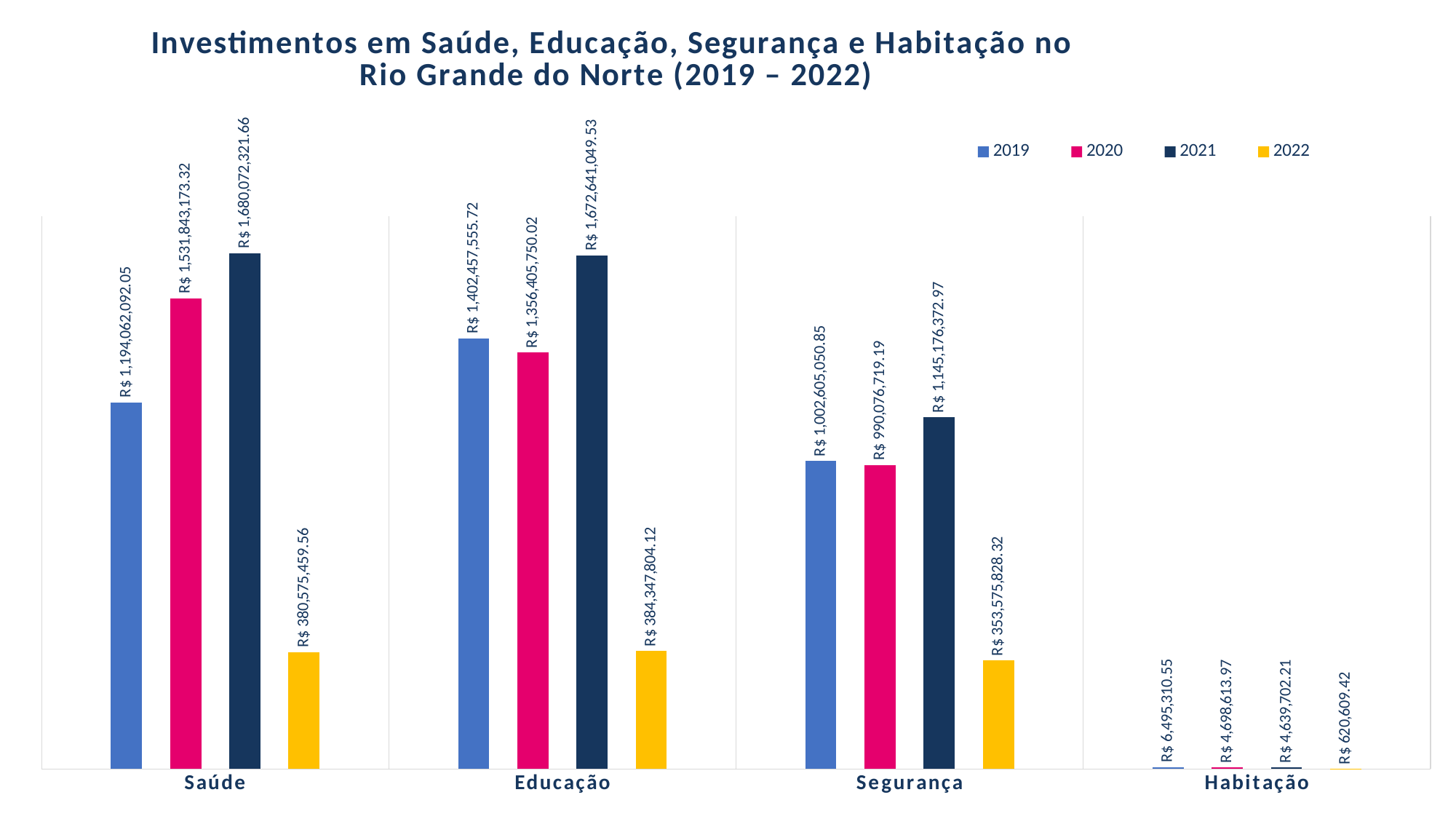
For Saúde, which is larger: the 2019 value or the 2020 value? 2020 What is the 2022 investment value for Segurança? R$ 353,575,828.32 Which category has the lowest investment values overall? Habitação Which year has the lowest investment value in Saúde? 2022 What is the 2021 investment value for Saúde? R$ 1,680,072,321.66 What is the 2019 investment value for Educação? R$ 1,402,457,555.72 How many categories are shown on the x axis? 4 What kind of chart is shown on the slide? Bar chart How many series does the legend list? 4 Which year has the highest investment value in Segurança? 2021 What is the difference between the 2021 and 2020 investment values for Saúde? R$ 148,229,148.34 What is the 2020 investment value for Habitação? R$ 4,698,613.97